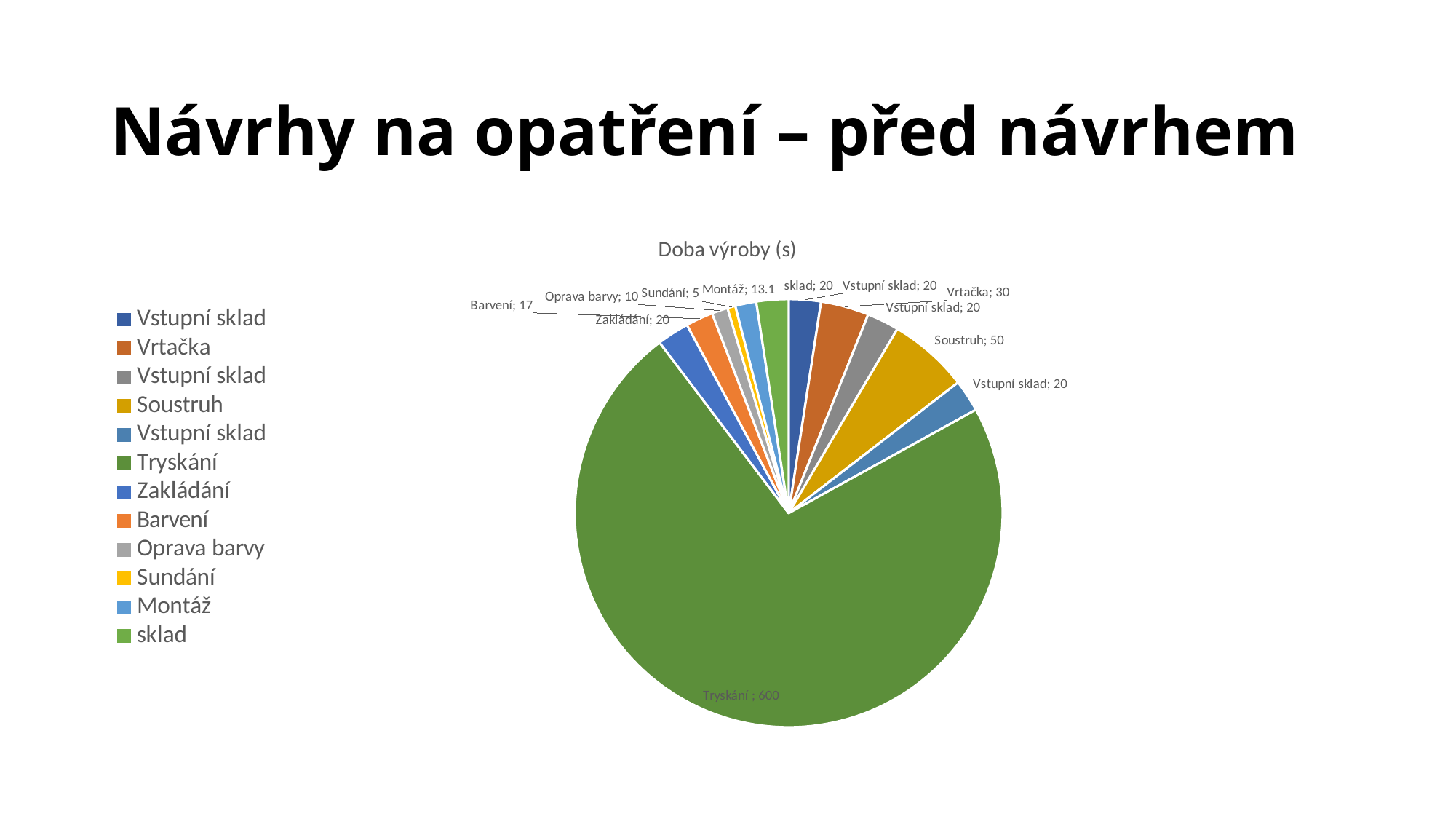
How many entries does the legend list? 12 What is the value for Montáž? 13.1 Which category has the smallest slice of the pie? Sundání What kind of chart is shown on the slide? pie chart What is the value for Oprava barvy? 10 What is the value for Soustruh? 50 What is the difference between the values for Soustruh and Vrtačka? 20 What is the title of the chart? Doba výroby (s) What is the value for Vrtačka? 30 Which category has the largest slice of the pie? Tryskání What is the value for Tryskání? 600 What is the value for Barvení? 17